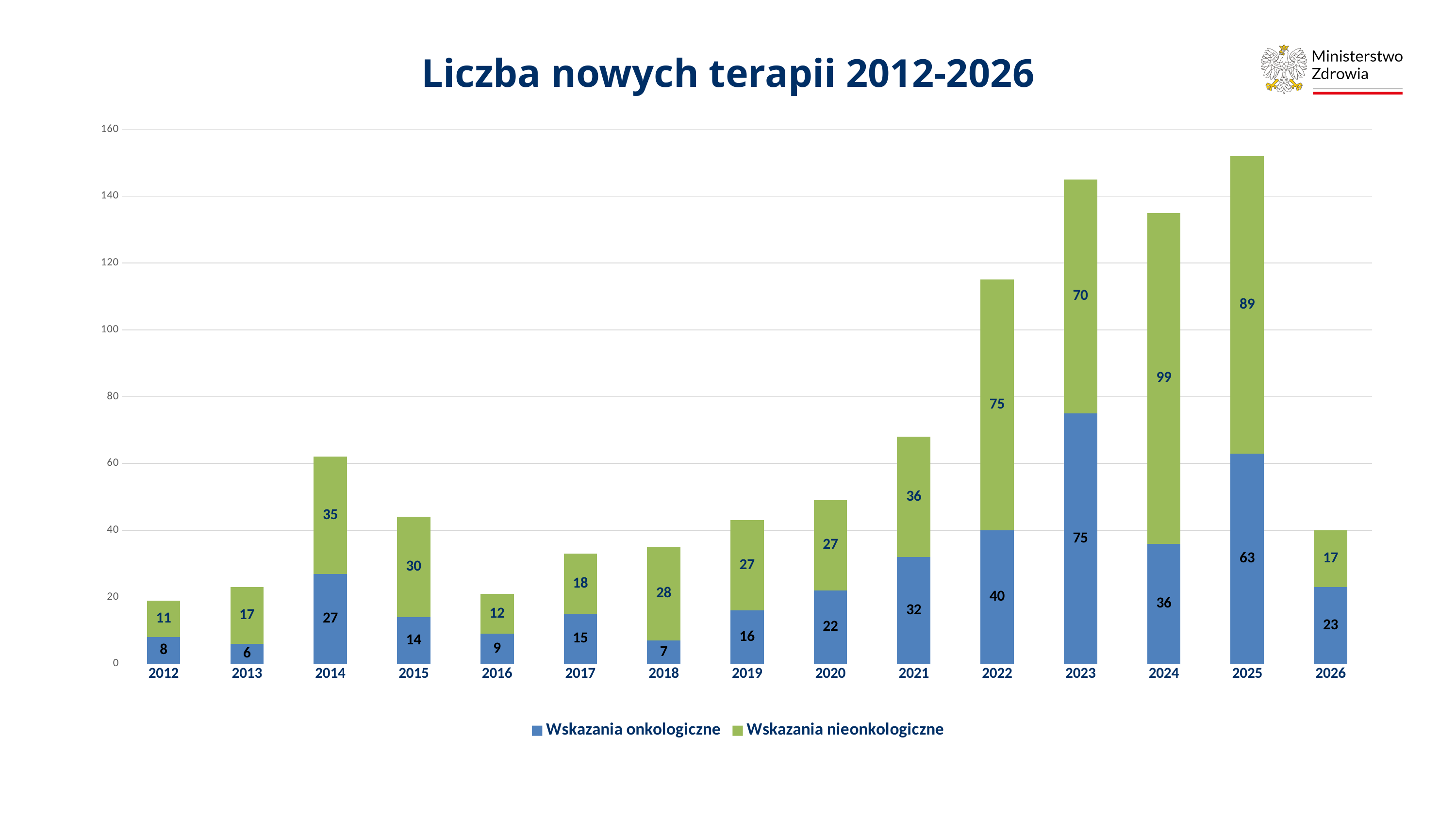
Which is larger in 2023: Wskazania onkologiczne or Wskazania nieonkologiczne? Wskazania onkologiczne Which year has the lowest value for Wskazania onkologiczne? 2013 What is the value for Wskazania nieonkologiczne in 2024? 99 How many years are shown on the x axis? 15 What is the total of the stacked bar for 2025? 152 What is the total of the stacked bar for 2014? 62 What is the value for Wskazania onkologiczne in 2012? 8 Which year has the highest value for Wskazania nieonkologiczne? 2024 How many series does the legend list? 2 What is the difference between the Wskazania nieonkologiczne values for 2025 and 2022? 14 What is the value for Wskazania onkologiczne in 2023? 75 What kind of chart is shown on the slide? Stacked bar chart